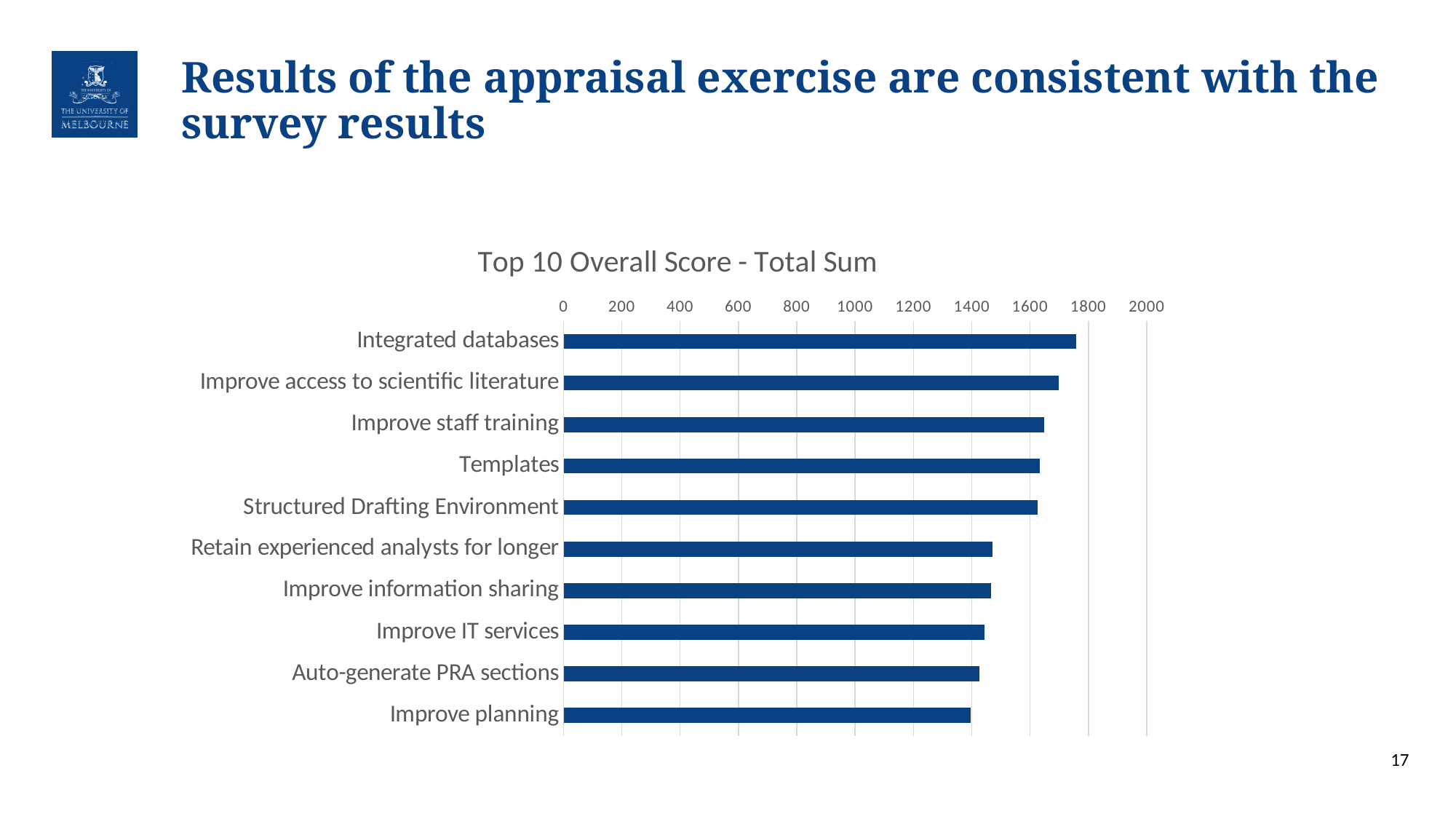
Which has a higher overall score, Improve access to scientific literature or Retain experienced analysts for longer? Improve access to scientific literature Which has a higher overall score, Improve staff training or Improve IT services? Improve staff training What kind of chart is shown on the slide? Bar chart What is the title of the chart? Top 10 Overall Score - Total Sum Is the value for Improve IT services greater or less than 1400? greater How many categories are plotted in the chart? 10 Is the value for Integrated databases greater or less than 1600? greater Is the value for Retain experienced analysts for longer greater or less than 1600? less Which category has the highest overall score? Integrated databases Which category has the lowest overall score? Improve planning